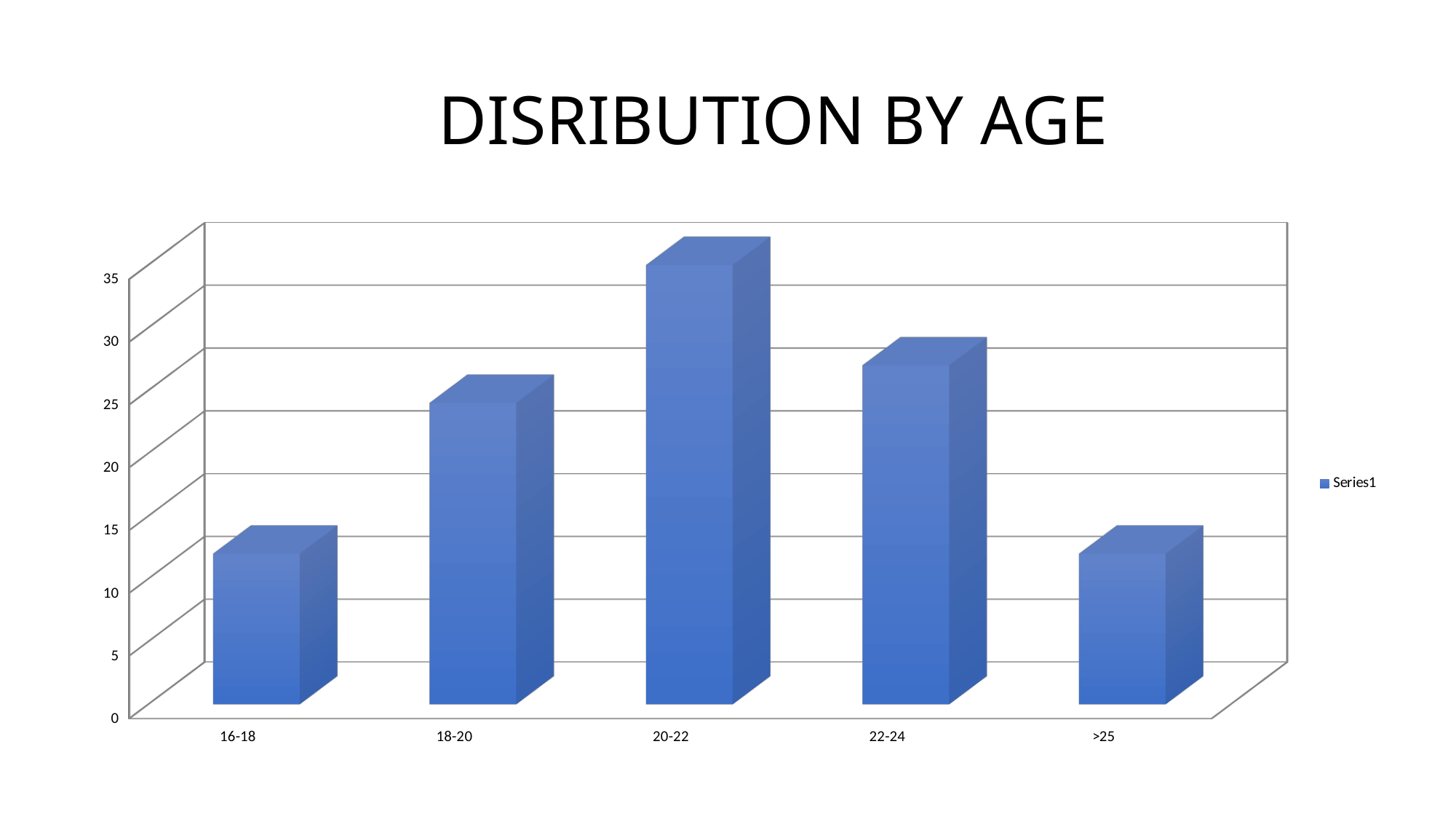
Is the value for 20-22 greater or less than 30? greater Which is larger, the value for 22-24 or the value for 16-18? 22-24 How many series does the legend list? 1 Is the value for 18-20 greater or less than 20? greater What kind of chart is shown on the slide? bar chart How many age categories are shown on the x axis? 5 Is the value for 16-18 greater or less than 15? less Which age category has the highest value? 20-22 Which is larger, the value for 20-22 or the value for 18-20? 20-22 What is the title of the chart? DISRIBUTION BY AGE What is the name of the series shown in the legend? Series1